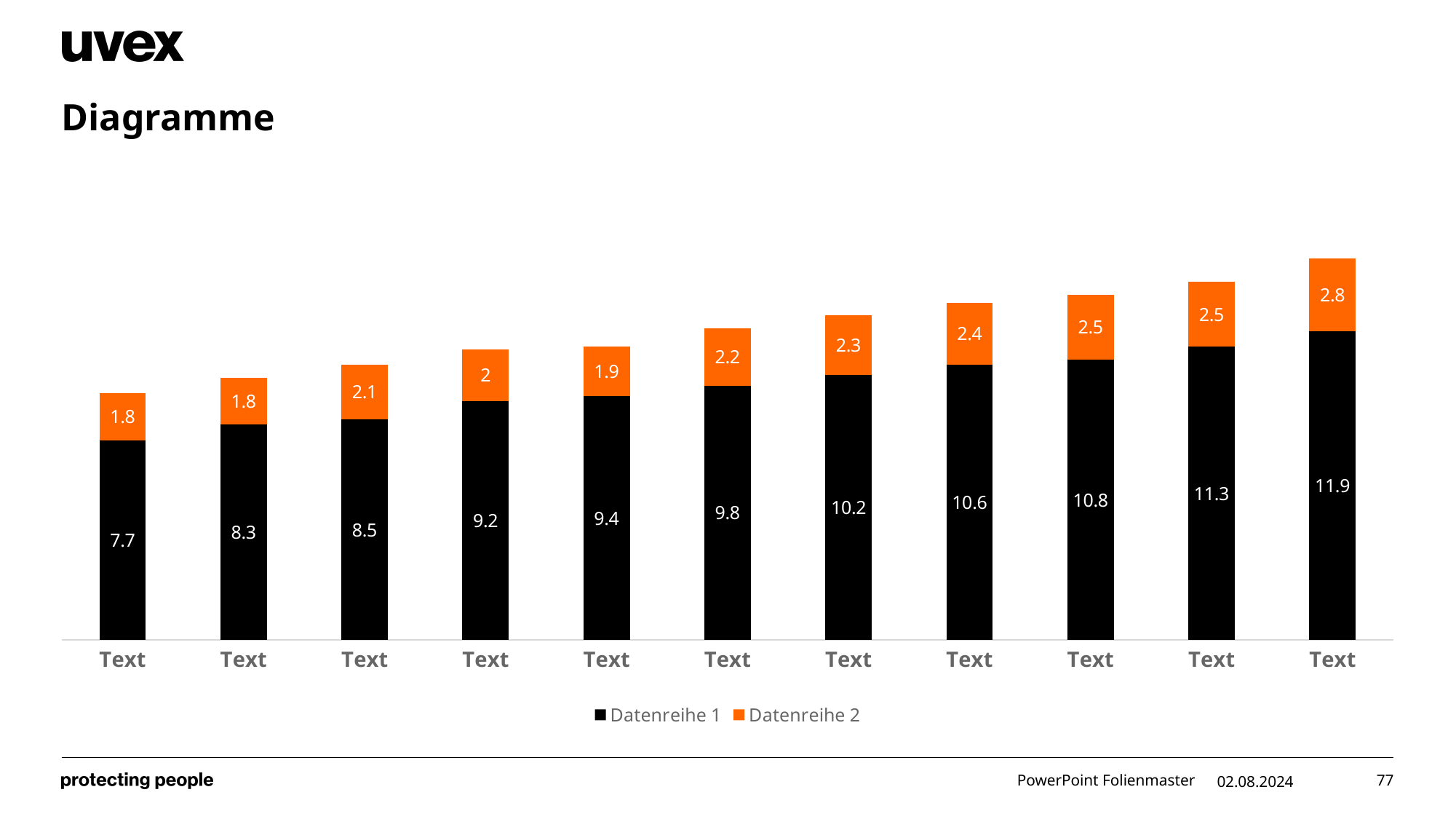
Do the Datenreihe 1 values rise or fall from left to right along the x axis? Rise What is the Datenreihe 1 value for the fourth bar from the left? 9.2 What is the Datenreihe 2 value for the rightmost bar? 2.8 How many series does the legend list? 2 What type of chart is shown on the slide? Stacked bar chart Which colour represents Datenreihe 2 in the chart? Orange What is the difference between the Datenreihe 1 values of the rightmost and leftmost bars? 4.2 How many bars (categories) does the chart show? 11 Which bar has the lowest Datenreihe 1 value? The leftmost bar (7.7) Which bar has the highest Datenreihe 1 value? The rightmost bar (11.9) What is the total of the rightmost stacked bar? 14.7 What is the Datenreihe 1 value for the leftmost bar? 7.7